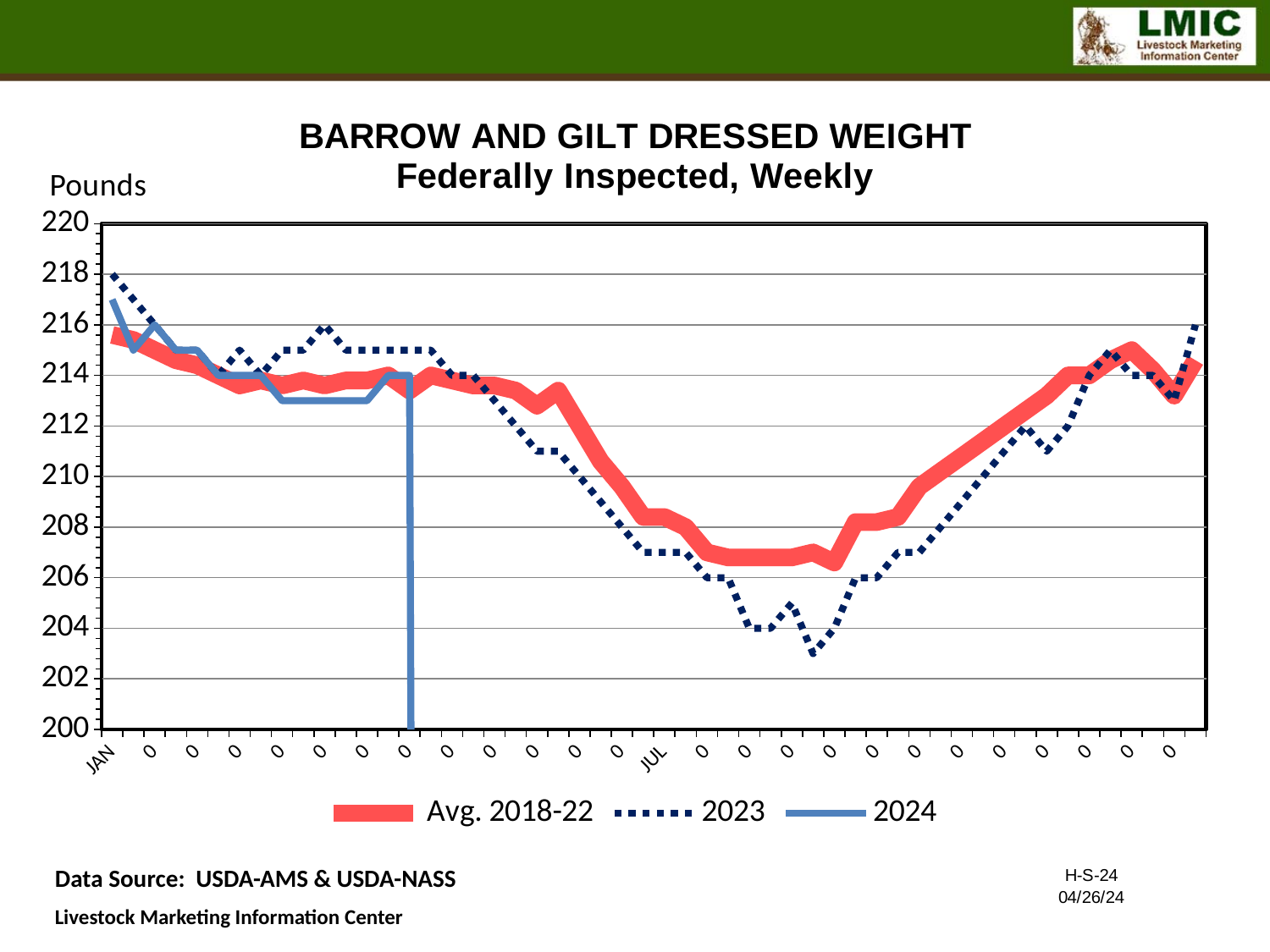
How many series does the legend list? 3 Is the value of the Avg. 2018-22 series at JUL greater or less than 210? less Is the value of the 2024 series at JAN greater or less than 216? greater Is the lowest value of the 2023 series greater or less than 204? less Does the Avg. 2018-22 series rise or fall from JAN to JUL? fall What kind of chart is shown on the slide? line chart At its lowest point, is the 2023 line above or below the Avg. 2018-22 line? below Does the 2023 series rise or fall from JUL to the end of the year? rise What are the three series listed in the legend? Avg. 2018-22, 2023, 2024 What is the main title of the chart? BARROW AND GILT DRESSED WEIGHT At JAN, which series has the higher value, 2023 or 2024? 2023